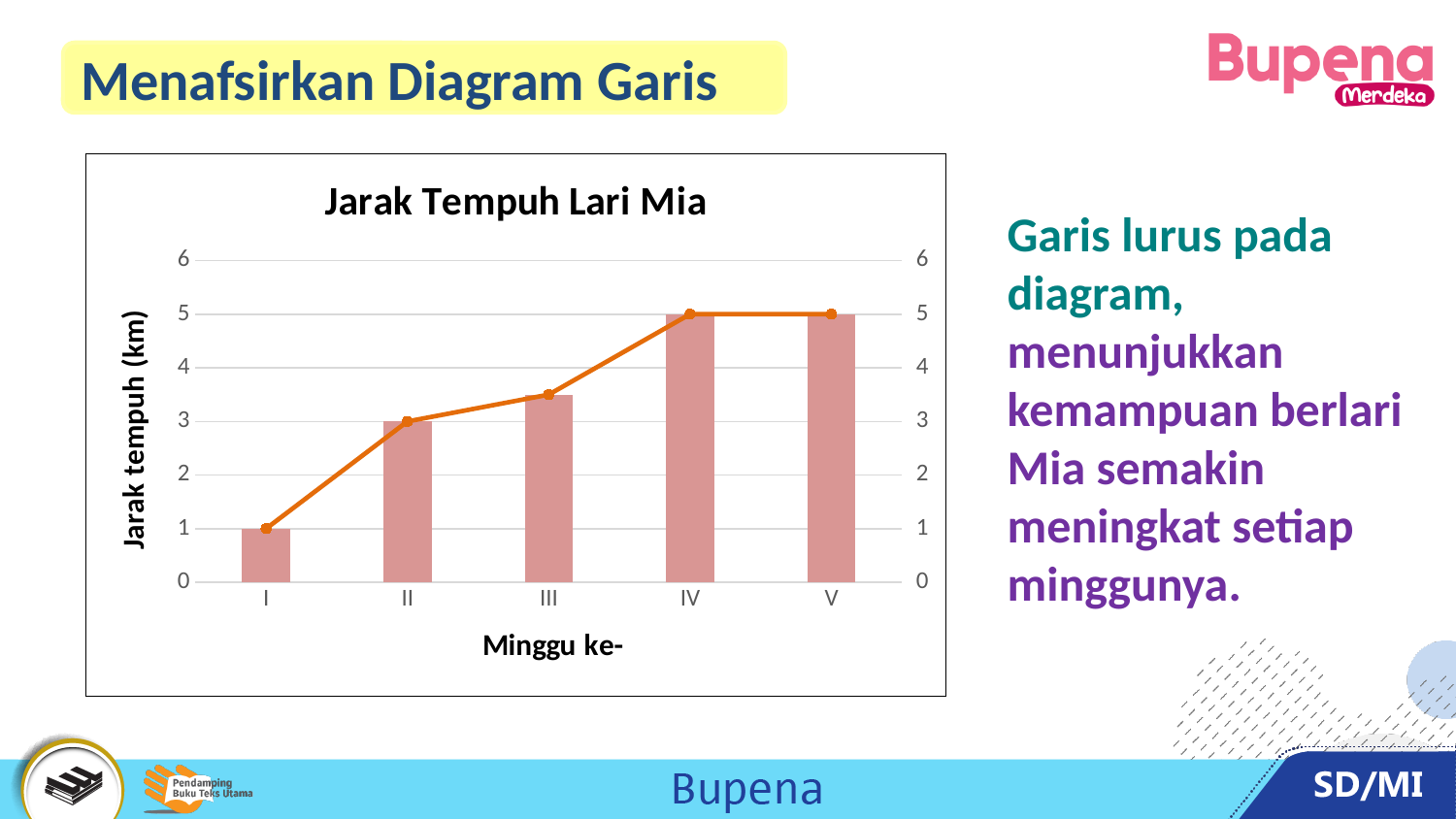
What is the distance run by Mia in week V? 5 km How many weeks are shown on the x axis? 5 Which is larger, the distance in week II or the distance in week I? Week II What is the distance run by Mia in week I? 1 km What is the distance run by Mia in week IV? 5 km Do the values rise or fall from week I to week V? rise What is the distance run by Mia in week II? 3 km Is the value for week III greater or less than 4? less What is the difference between the distance in week IV and the distance in week I? 4 km What is the title of the chart? Jarak Tempuh Lari Mia Is the value for week III greater or less than 3? greater Which week has the lowest distance run? I